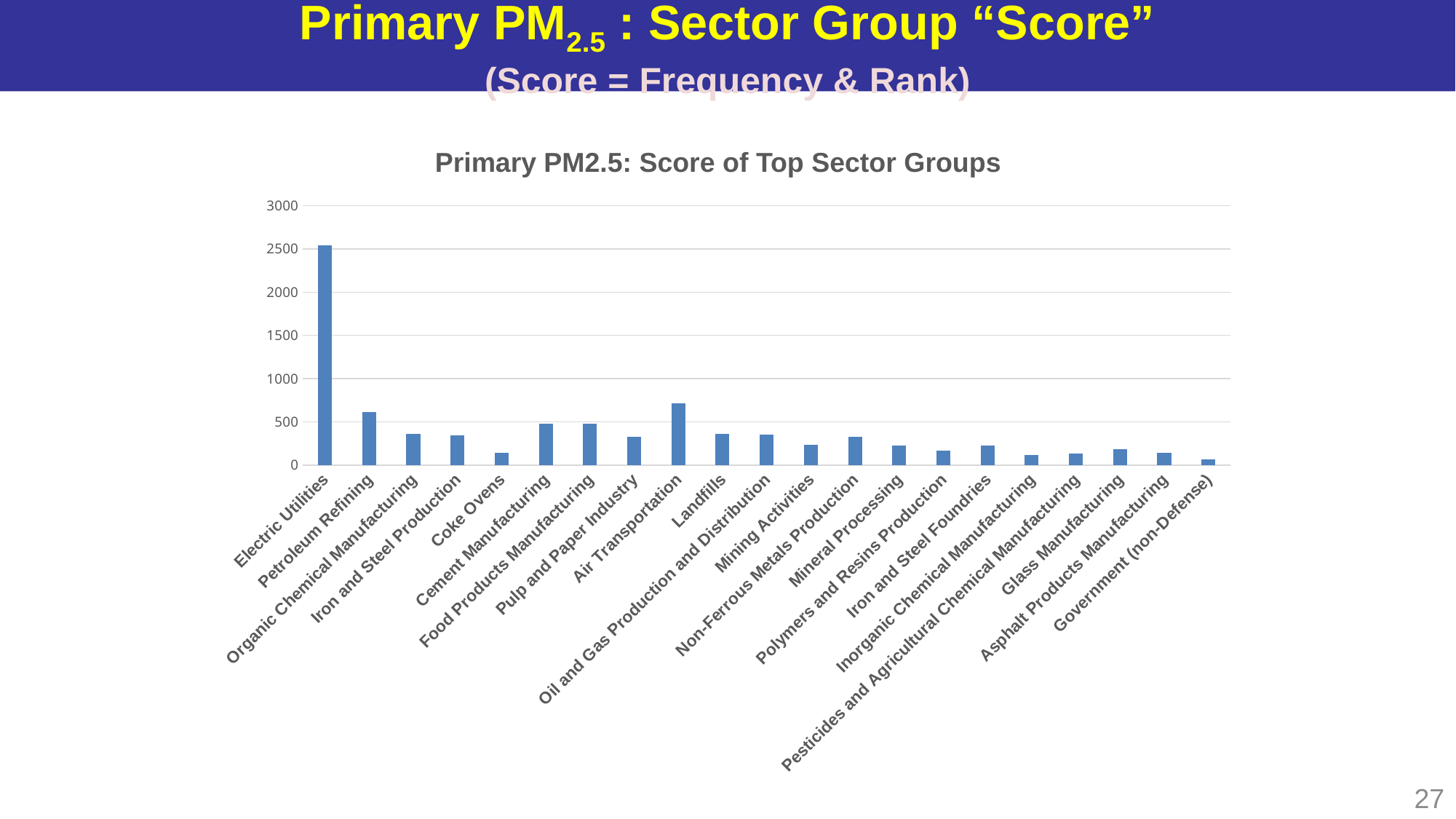
What kind of chart is shown on the slide? bar chart Is the score for Electric Utilities greater or less than 2000? greater How many sector groups are plotted in the chart? 21 Which has a higher score, Air Transportation or Petroleum Refining? Air Transportation Is the score for Coke Ovens greater or less than 500? less Which has a higher score, Landfills or Coke Ovens? Landfills What is the highest value shown on the vertical axis? 3000 Is the score for Petroleum Refining greater or less than 500? greater What is the title of the chart? Primary PM2.5: Score of Top Sector Groups Which sector group has the lowest score? Government (non-Defense) Which sector group has the highest score? Electric Utilities